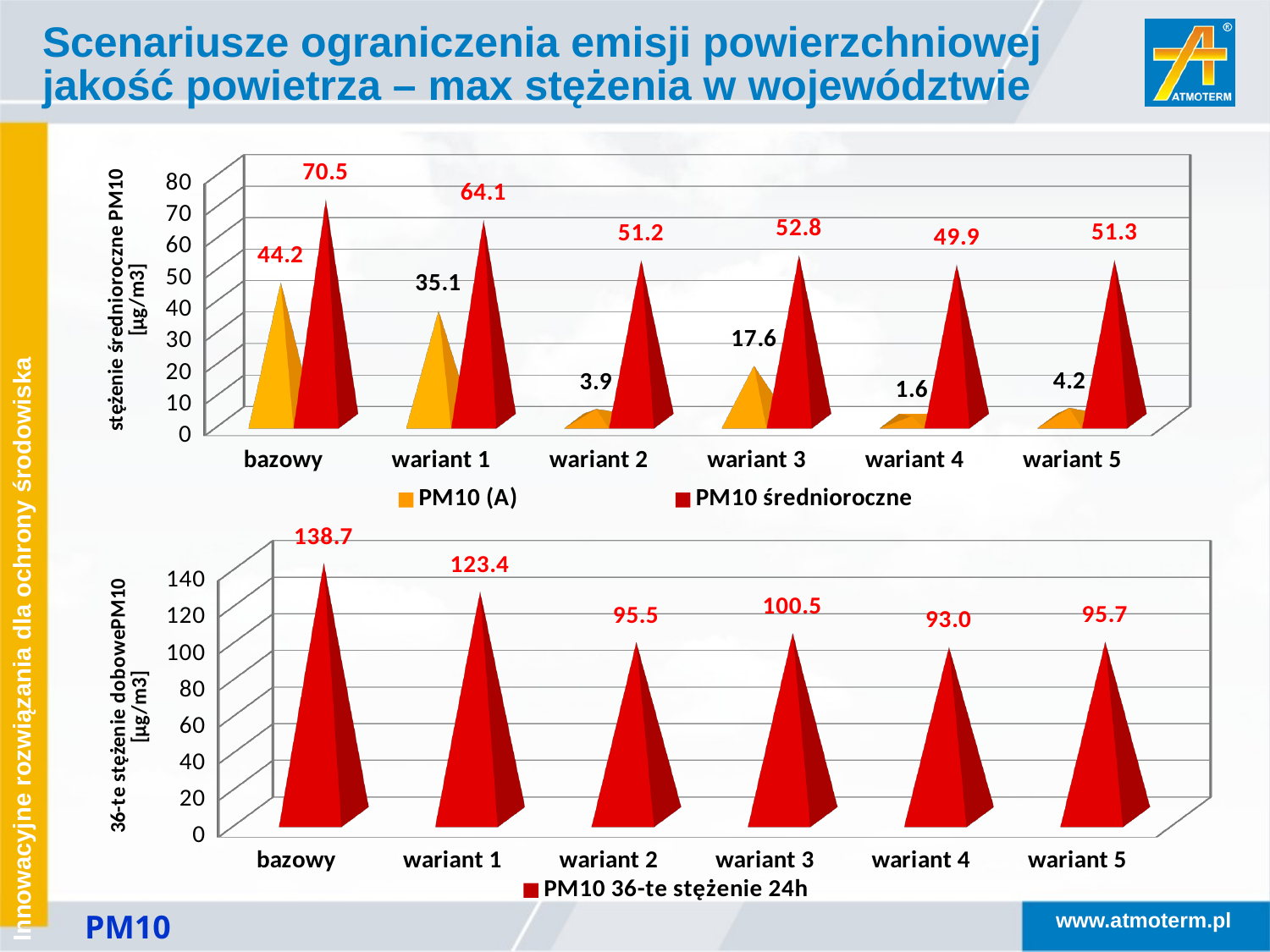
In the bottom chart, which category has the highest value? bazowy In the bottom chart, what is the difference between the values for bazowy and wariant 2? 43.2 How many categories are shown on the x axis of the bottom chart? 6 In the bottom chart, what is the PM10 36-te stężenie 24h value for wariant 4? 93.0 In the top chart, what is the PM10 (A) value for wariant 3? 17.6 In the top chart, what is the PM10 średnioroczne value for bazowy? 70.5 In the top chart, which category has the lowest PM10 (A) value? wariant 4 In the bottom chart, which category has the lowest value? wariant 4 In the bottom chart, is the value for wariant 3 larger or smaller than the value for wariant 5? larger In the top chart, what is the difference between the PM10 średnioroczne values for bazowy and wariant 1? 6.4 In the top chart, which category has the highest PM10 średnioroczne value? bazowy In the top chart, how many series does the legend list? 2